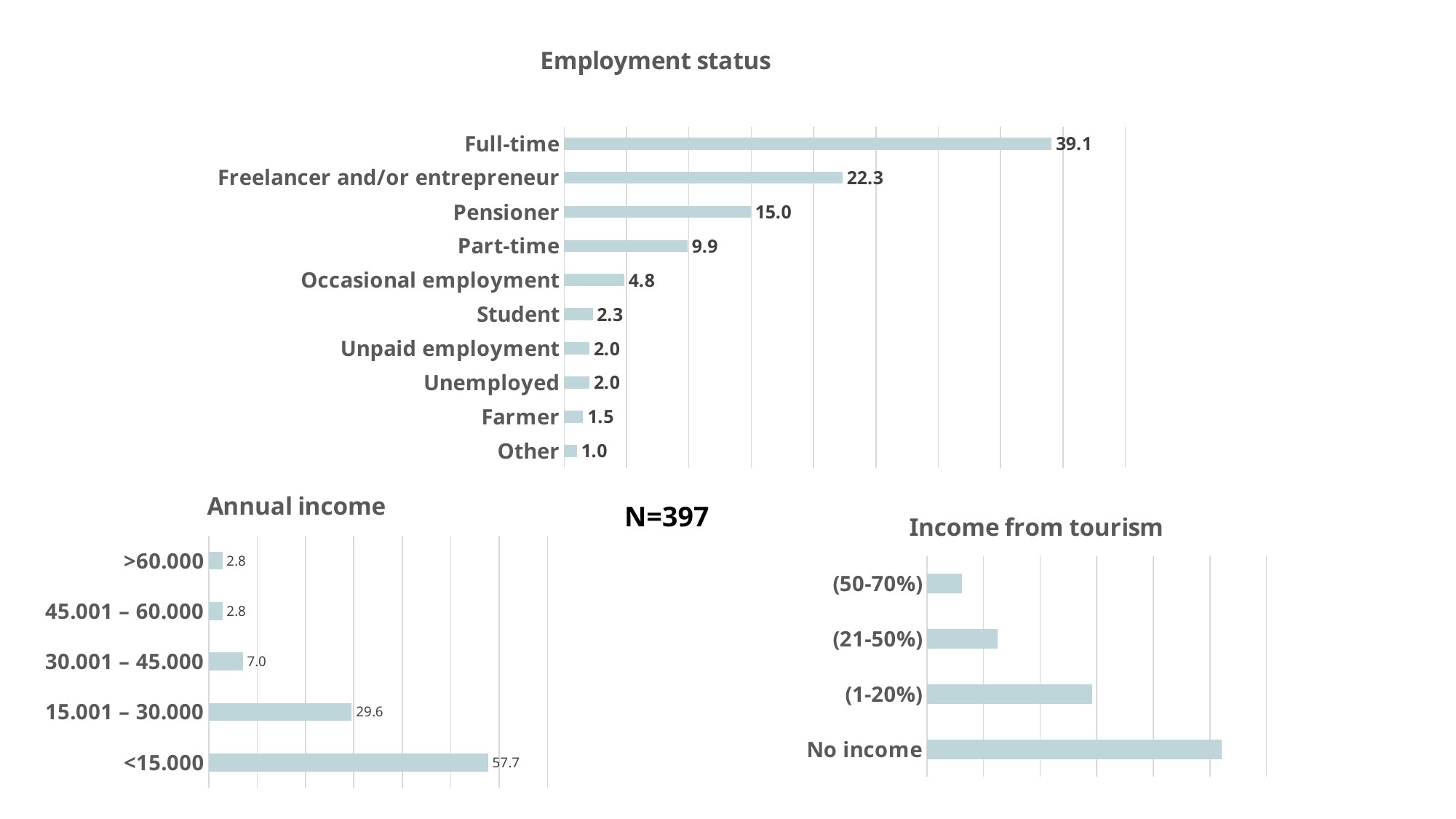
In the Annual income chart, what is the value for 15.001 – 30.000? 29.6 What kind of chart is the Income from tourism chart? Bar chart In the Employment status chart, what is the difference between Full-time and Freelancer and/or entrepreneur? 16.8 In the Annual income chart, which category has the highest value? <15.000 In the Income from tourism chart, which category has the highest value? No income In the Employment status chart, how many categories are shown? 10 In the Income from tourism chart, which category has the lowest value? (50-70%) In the Employment status chart, what is the value for Pensioner? 15.0 In the Employment status chart, which is larger: Part-time or Occasional employment? Part-time In the Employment status chart, which category has the lowest value? Other In the Employment status chart, which category has the highest value? Full-time In the Annual income chart, what is the difference between <15.000 and 15.001 – 30.000? 28.1